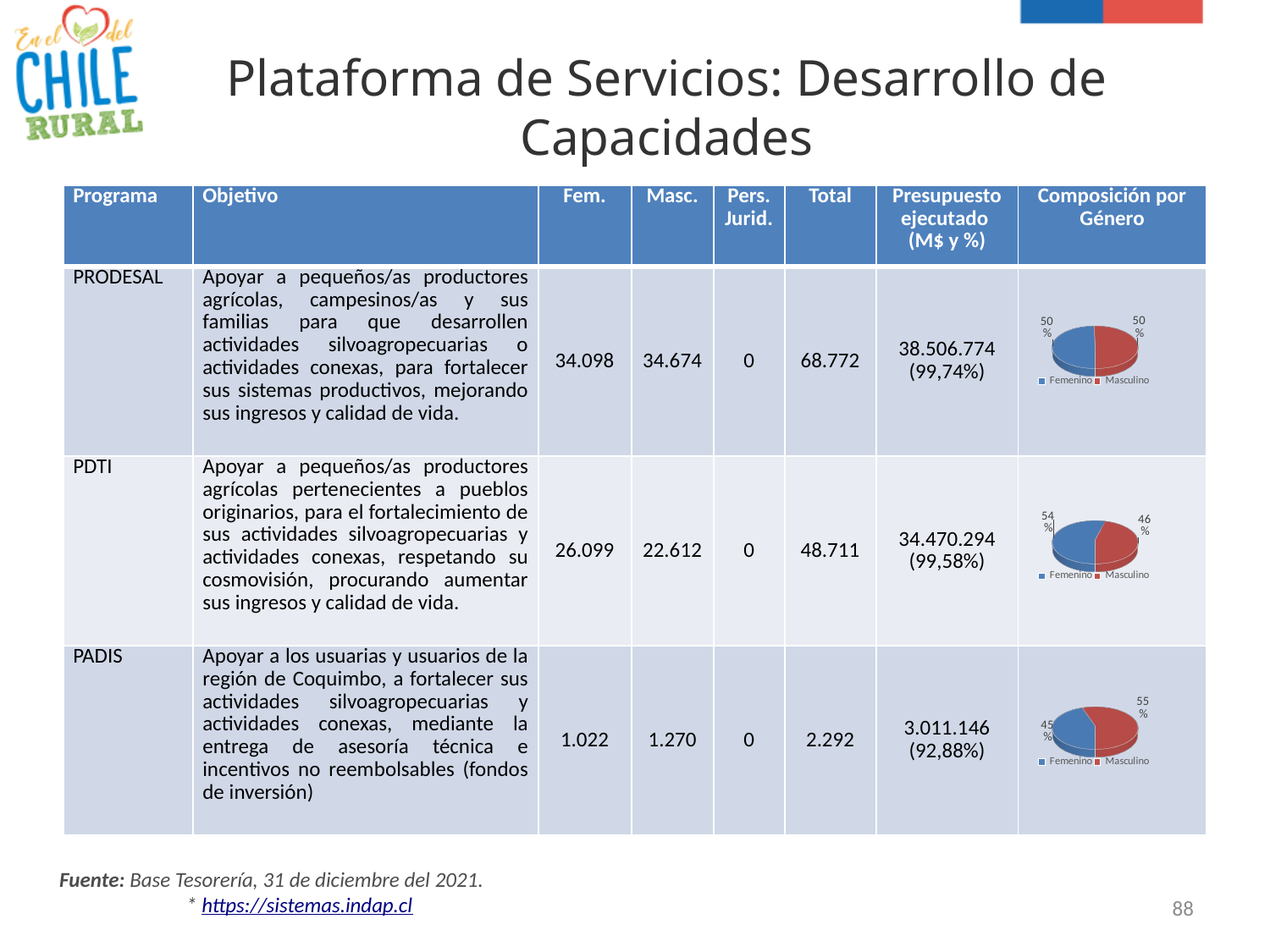
In the PDTI row pie chart, what percentage is shown for Femenino? 54% In the PDTI row pie chart, which slice is larger, Femenino or Masculino? Femenino In the PDTI row pie chart, what percentage is shown for Masculino? 46% In the PADIS row pie chart, which colour represents Femenino? blue What kind of chart is shown in the Composición por Género column for the PRODESAL row? pie chart In the PADIS row pie chart, what is the difference in percentage points between the Masculino and Femenino slices? 10 In the PRODESAL row pie chart, what percentage is shown for Femenino? 50% How many entries does the legend of the PRODESAL row pie chart list? 2 In the PADIS row pie chart, what percentage is shown for Femenino? 45% In the PADIS row pie chart, which slice is larger, Femenino or Masculino? Masculino In the PDTI row pie chart, what is the difference in percentage points between the Femenino and Masculino slices? 8 In the PADIS row pie chart, what percentage is shown for Masculino? 55%